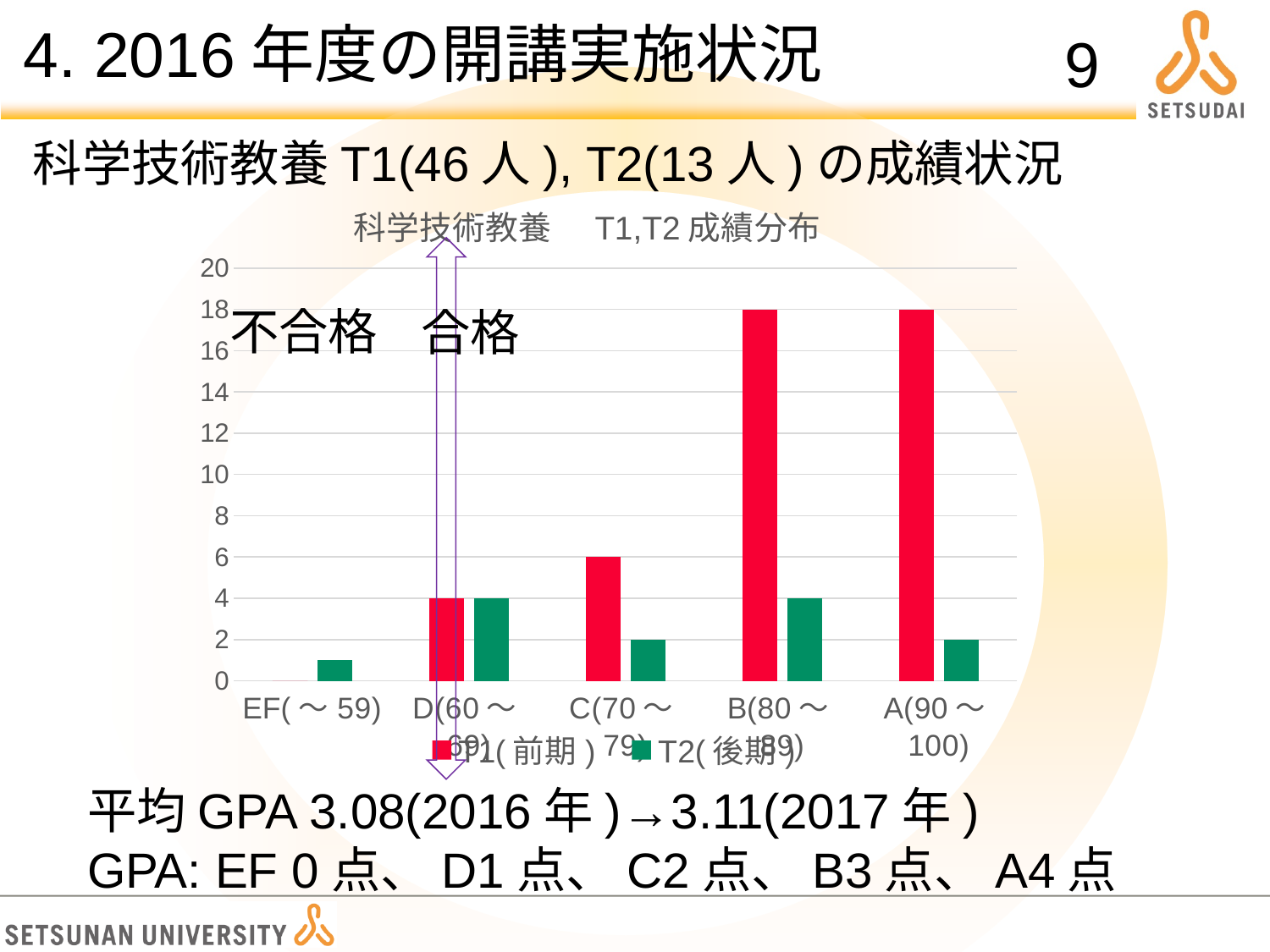
For T1(前期), which category has the larger value, B(80～89) or C(70～79)? B(80～89) What is the value for T2(後期) in the D(60～69) category? 4 What is the value for T2(後期) in the B(80～89) category? 4 What are the two series names listed in the chart legend? T1(前期) and T2(後期) What is the difference between the T1(前期) and T2(後期) values in the B(80～89) category? 14 Is the value for T2(後期) in the EF(～59) category greater or less than 2? less What is the value for T1(前期) in the C(70～79) category? 6 How many series does the chart legend list? 2 What is the value for T1(前期) in the B(80～89) category? 18 How many grade categories are shown on the x axis of the chart? 5 In the C(70～79) category, which series has the larger value, T1(前期) or T2(後期)? T1(前期) What kind of chart is shown on the slide? bar chart